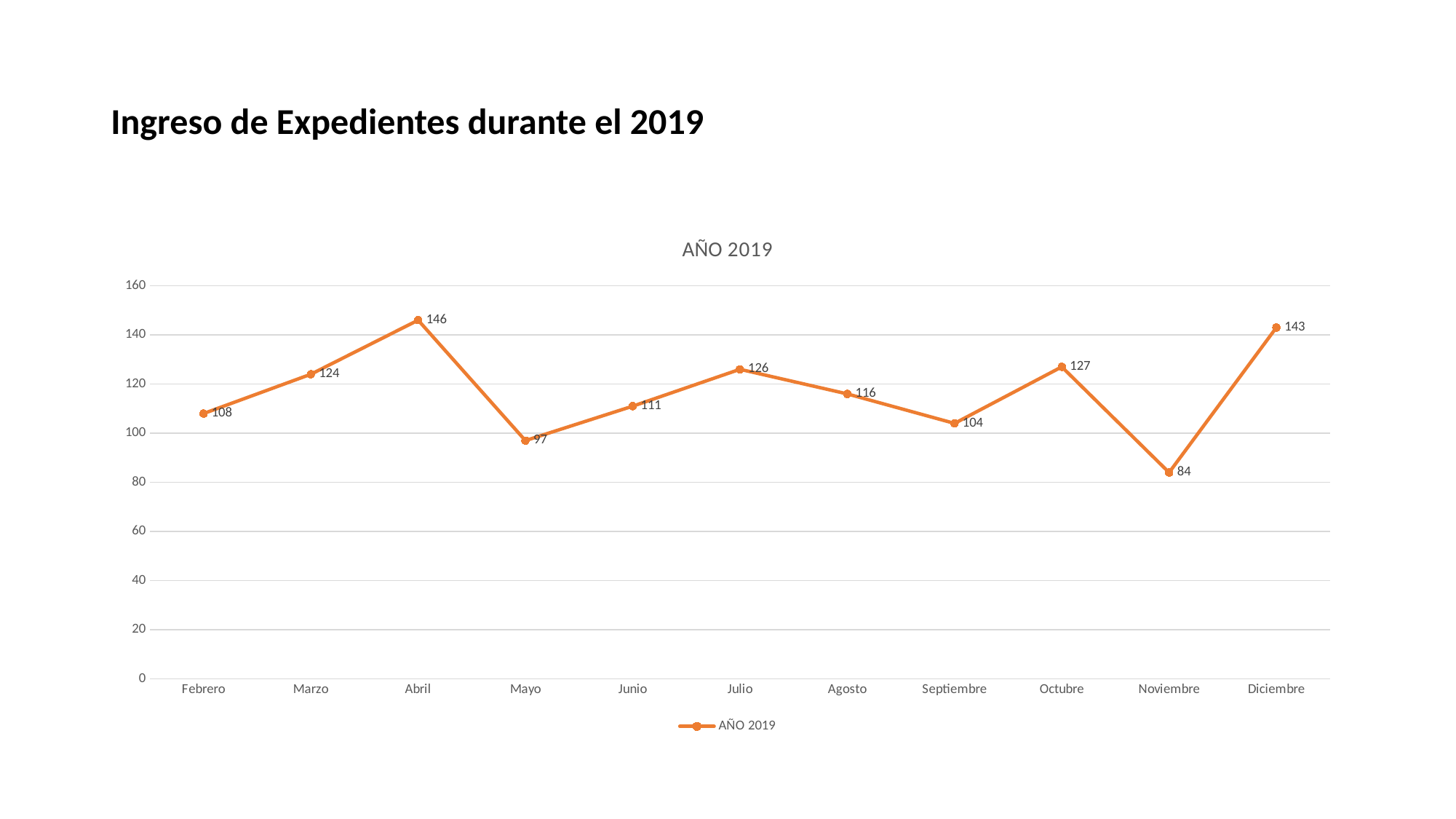
What is the title of the chart? AÑO 2019 What kind of chart is shown? line chart How many series does the legend list? 1 Which is larger, the value for Julio or the value for Agosto? Julio What is the value for Abril? 146 Which month has the lowest value? Noviembre What is the difference between the values for Abril and Mayo? 49 How many months are plotted on the x axis? 11 Is the value for Diciembre greater or less than 140? greater What is the value for Septiembre? 104 Which month has the highest value? Abril What is the value for Noviembre? 84